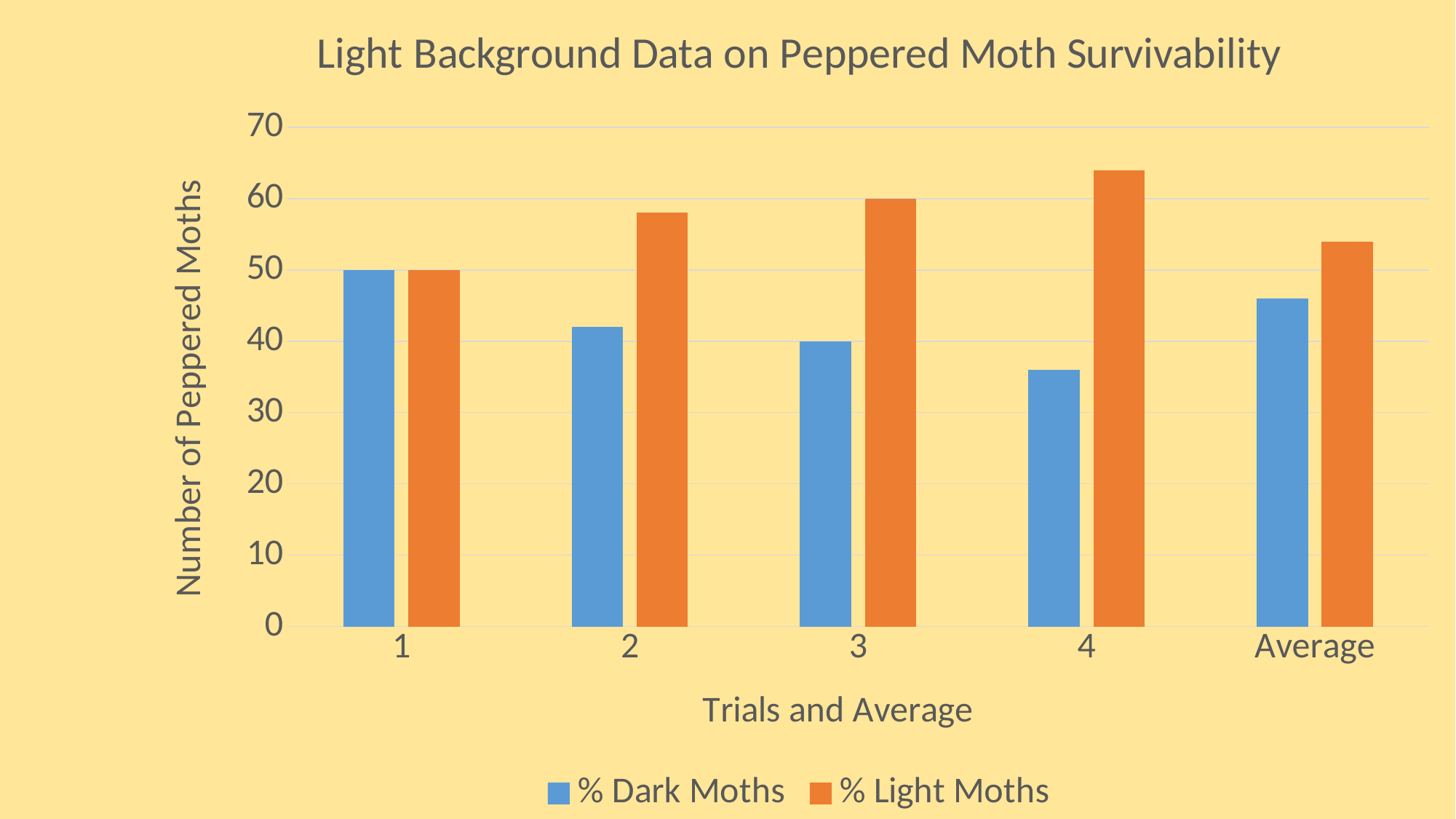
Which is larger in trial 2: % Dark Moths or % Light Moths? % Light Moths What type of chart is shown on the slide? bar chart What is the value for % Light Moths in trial 3? 60 Is the value for % Dark Moths in trial 4 greater or less than 40? less Is the value for % Light Moths in the Average category greater or less than 50? greater What is the difference between % Light Moths and % Dark Moths in trial 3? 20 What is the value for % Dark Moths in trial 1? 50 What is the value for % Dark Moths in trial 3? 40 Which category has the lowest value for % Dark Moths? 4 Which category has the highest value for % Light Moths? 4 How many series does the legend list? 2 How many categories are shown on the x axis? 5